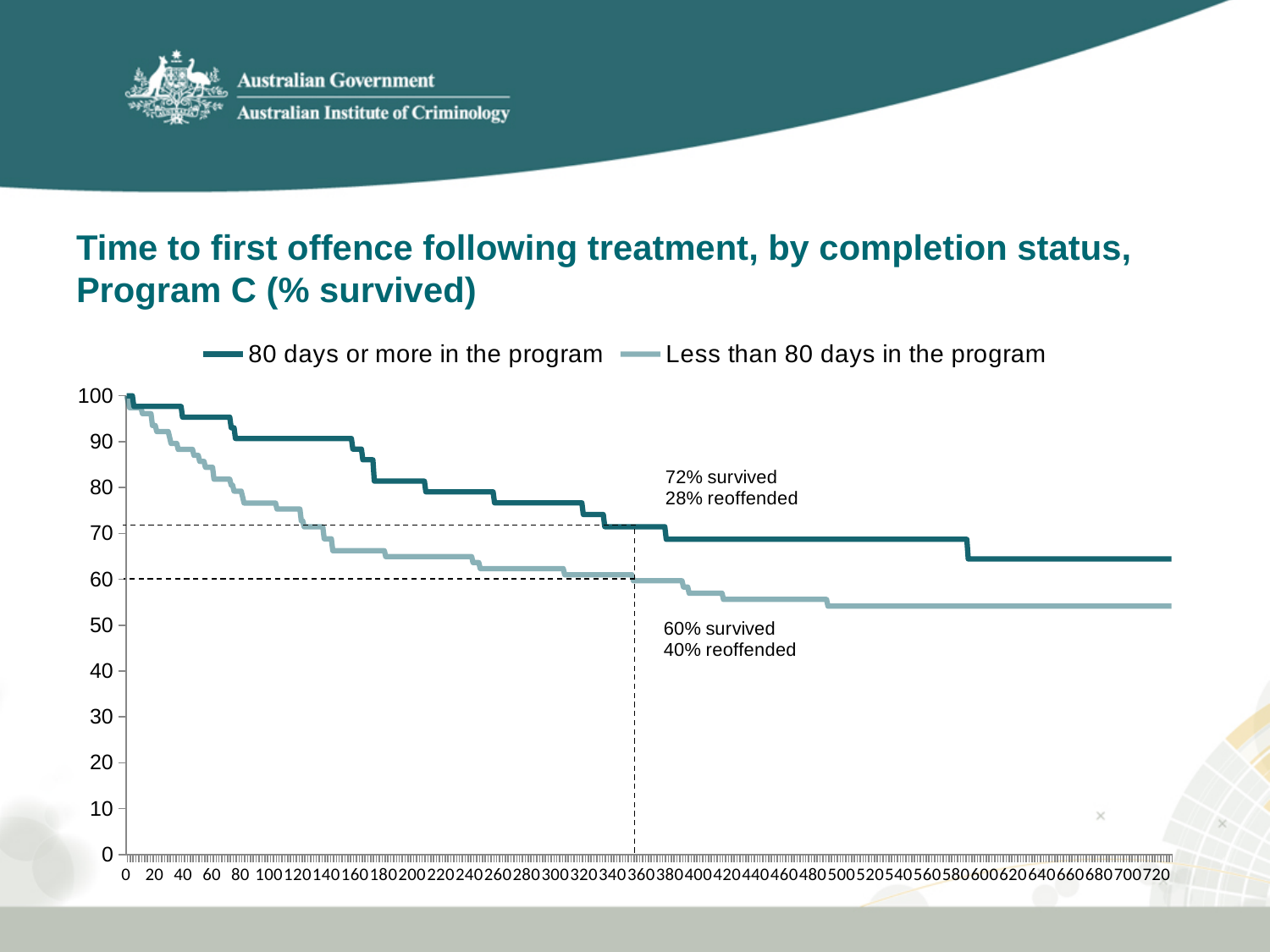
What is the difference in percentage points between the survival rates of the two groups at day 360 (72% vs 60%)? 12 How many series does the legend list? 2 At day 720, is the value for 'Less than 80 days in the program' greater or less than 60? less Which series has the higher survival percentage at day 360? 80 days or more in the program According to the annotation, what percentage of the 'Less than 80 days in the program' group had reoffended at day 360? 40% What kind of chart is shown on the slide? line chart What is the title of the chart? Time to first offence following treatment, by completion status, Program C (% survived) Do the survival percentages rise or fall as the number of days increases along the x axis? fall According to the annotation, what percentage of the '80 days or more in the program' group had reoffended at day 360? 28% According to the annotation, what percentage of the 'Less than 80 days in the program' group had survived at the dashed vertical line (day 360)? 60% According to the annotation, what percentage of the '80 days or more in the program' group had survived at the dashed vertical line (day 360)? 72% What are the two series named in the legend? 80 days or more in the program; Less than 80 days in the program